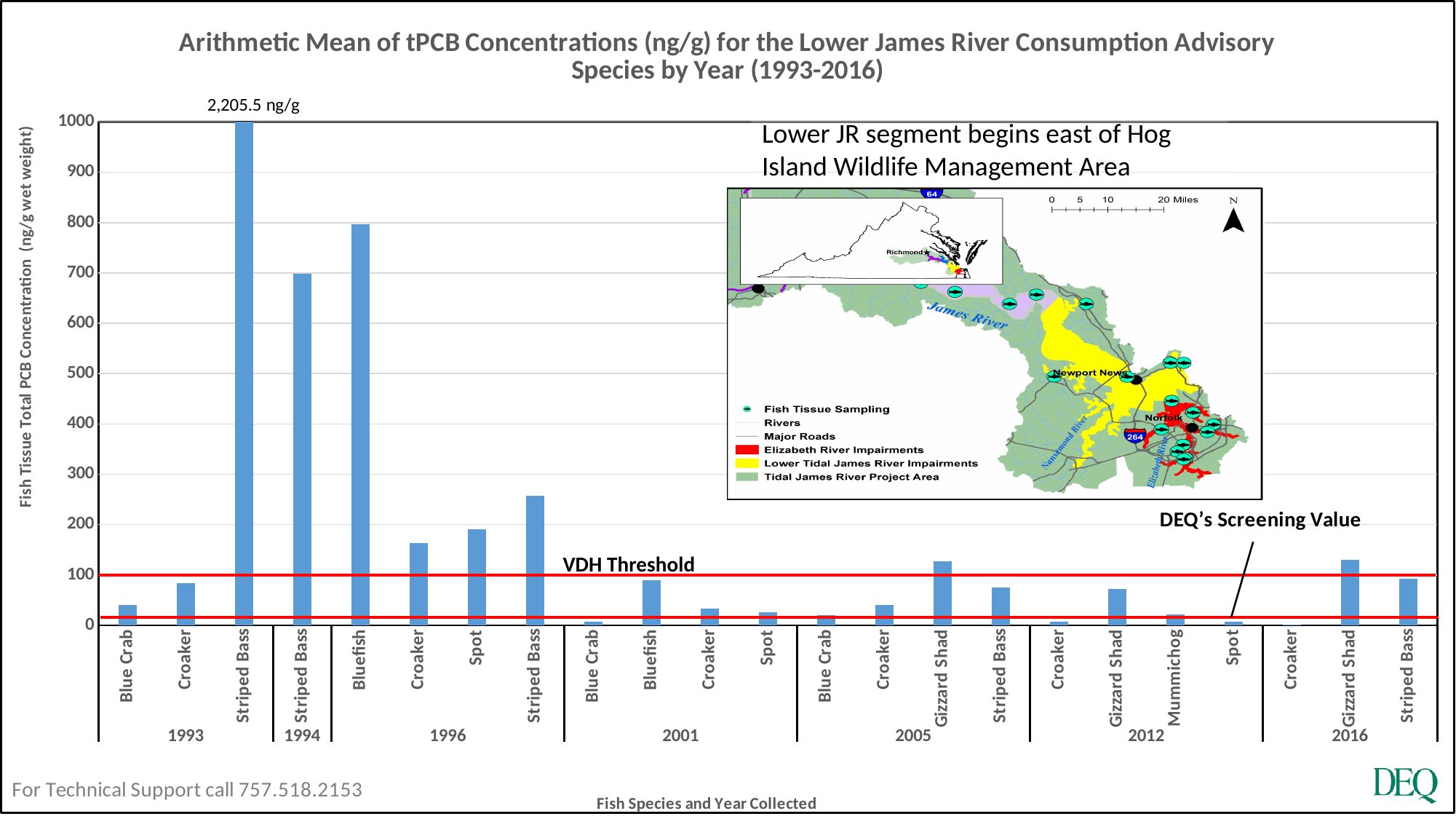
Is the value for Gizzard Shad in 2005 greater or less than 100? greater What are the two red horizontal lines on the chart labelled? VDH Threshold and DEQ's Screening Value Which species and year has the highest tPCB concentration? Striped Bass, 1993 Is the value for Croaker in 1996 greater or less than 100? greater Which is larger, the value for Croaker in 1996 or Spot in 1996? Spot in 1996 How many bars are plotted on the chart? 23 Is the value for Bluefish in 2001 greater or less than 100? less What is the value printed for Striped Bass in 1993? 2,205.5 ng/g What kind of chart is shown? bar chart Which is larger, the value for Striped Bass in 1994 or Bluefish in 1996? Bluefish in 1996 How many years are shown along the x axis? 7